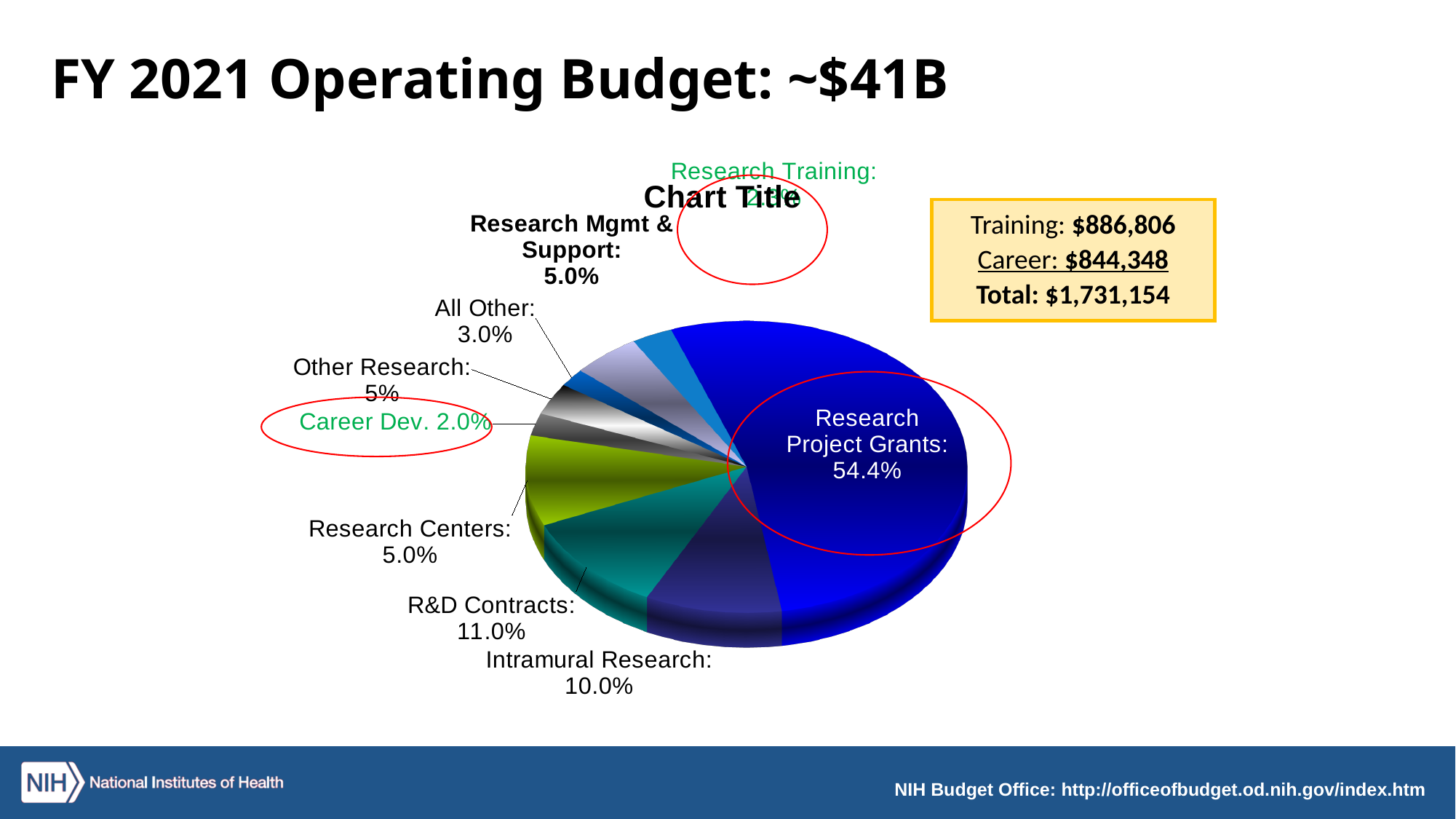
How many labeled slices does the pie chart have? 9 Which category has the largest slice of the pie? Research Project Grants What is the value shown for Research Mgmt & Support? 5.0% What share of the pie does Research Project Grants represent? 54.4% What is the value shown for Intramural Research? 10.0% What title text is printed above the pie chart? Chart Title Which is larger, R&D Contracts or Intramural Research? R&D Contracts What is the value shown for R&D Contracts? 11.0% What is the value shown for All Other? 3.0% What kind of chart is shown on the slide? pie chart What is the value shown for Career Dev.? 2.0% What is the difference between Research Project Grants and R&D Contracts? 43.4%